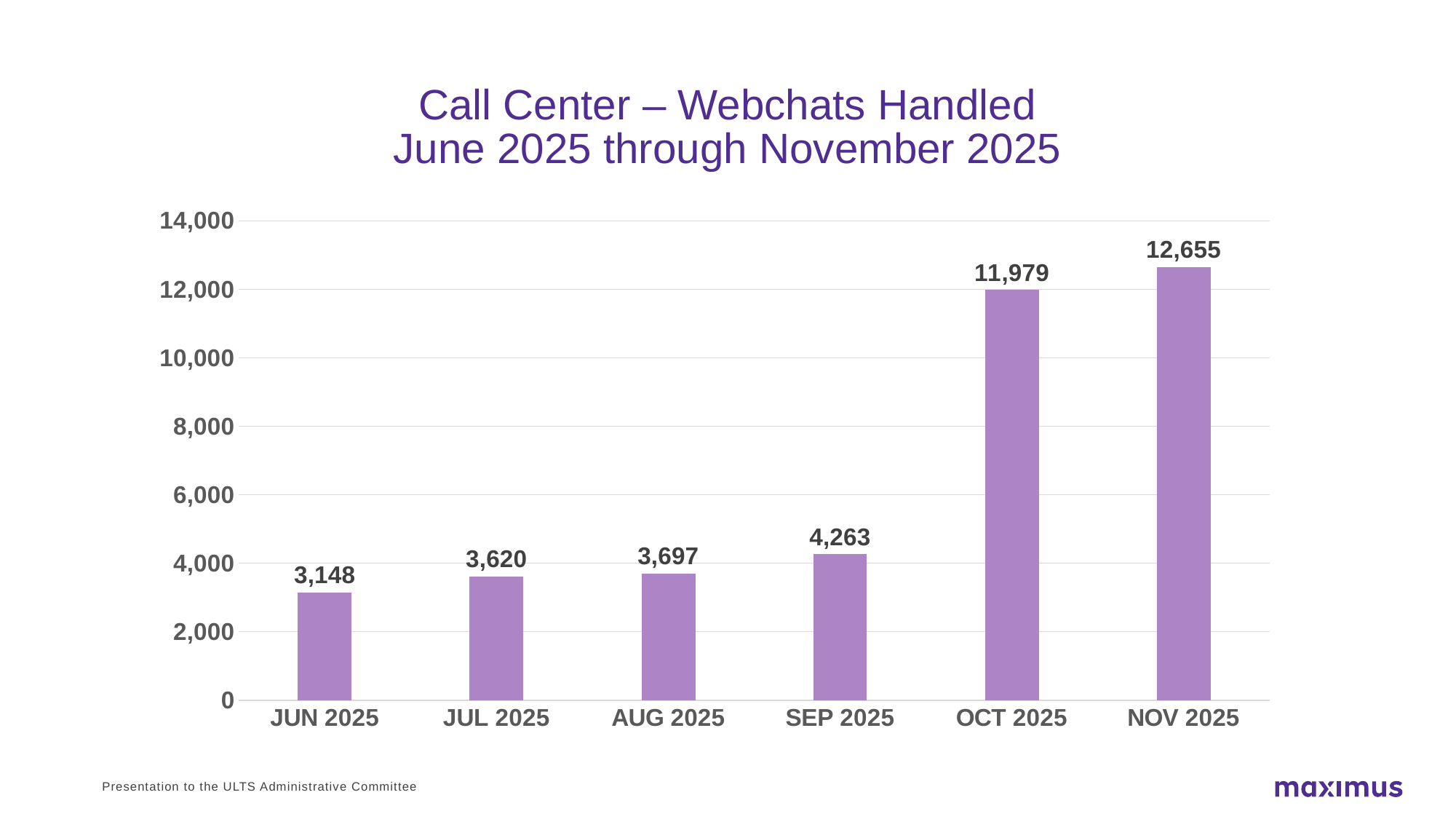
What is the difference between the values for NOV 2025 and OCT 2025? 676 Is the value for OCT 2025 greater or less than 10,000? greater What is the title of the chart? Call Center – Webchats Handled June 2025 through November 2025 Which month has the lowest number of webchats handled? JUN 2025 Which is larger, the value for AUG 2025 or the value for SEP 2025? SEP 2025 How many webchats were handled in JUN 2025? 3,148 How many months are shown on the x axis? 6 What is the value shown for OCT 2025? 11,979 What is the value shown for SEP 2025? 4,263 What is the difference between the values for JUL 2025 and JUN 2025? 472 What kind of chart is shown on the slide? bar chart Which month has the highest number of webchats handled? NOV 2025